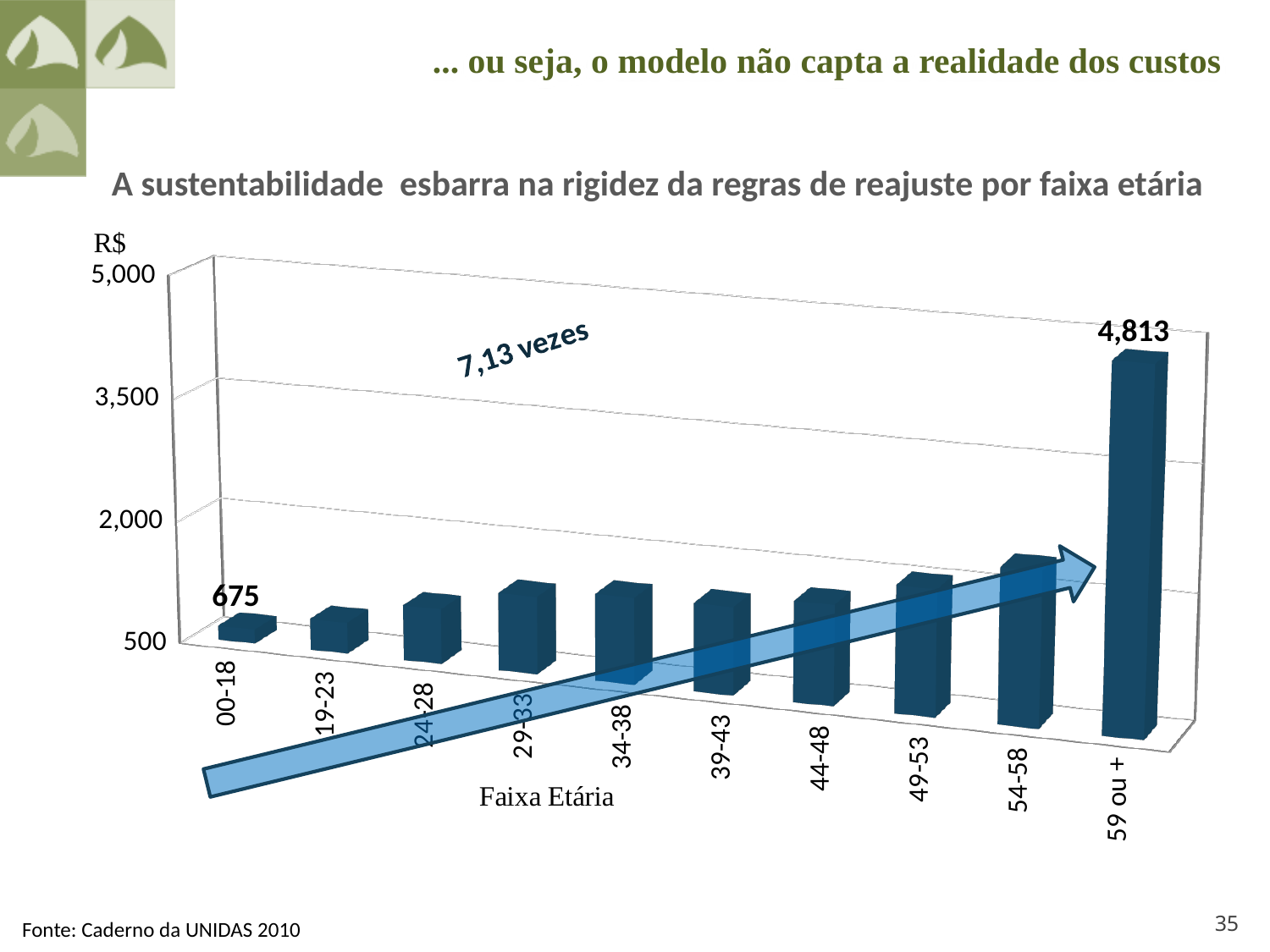
Is the value for 59 ou + greater or less than 3,500? greater Is the value for 34-38 greater or less than 2,000? less What is the difference between the values for 59 ou + and 00-18? 4,138 Which age group has the lowest value? 00-18 How many age groups are shown on the x axis? 10 Which is larger, the value for 59 ou + or the value for 00-18? 59 ou + Which age group has the highest value? 59 ou + What is the value for the 59 ou + age group? 4,813 What kind of chart is shown on the slide? Bar chart What is the title of the x axis? Faixa Etária Do the values generally rise or fall as the age groups increase along the x axis? Rise What is the value for the 00-18 age group? 675